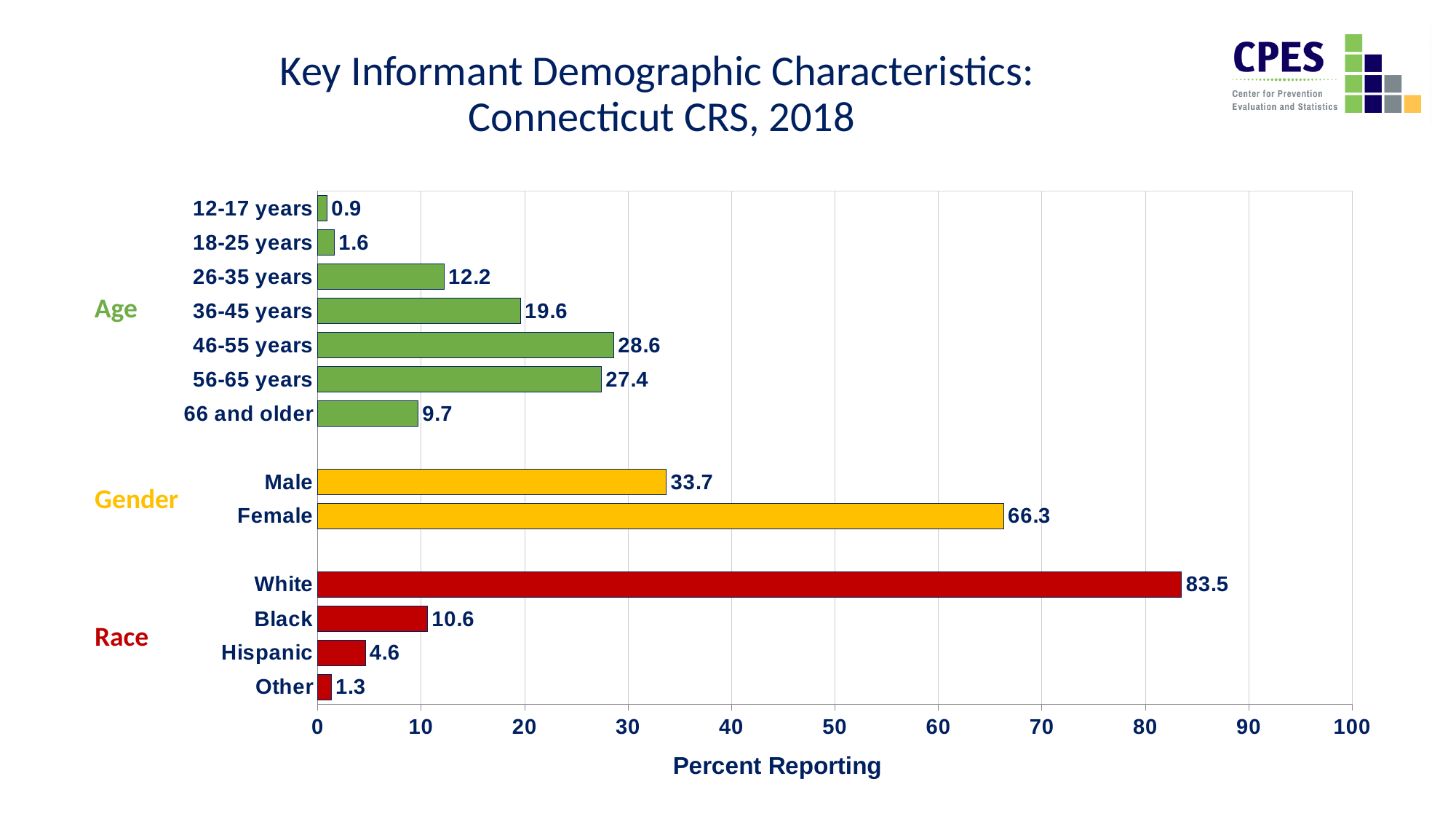
What is the percent reporting for the 46-55 years age group? 28.6 Which has a higher percent reporting, Black or 66 and older? Black What is the label of the x axis? Percent Reporting Which age group has the lowest percent reporting? 12-17 years Is the value for White greater or less than 80? greater Which age group has the highest percent reporting? 46-55 years What is the percent reporting for Hispanic? 4.6 What is the percent reporting for Female? 66.3 How many age groups are shown in the chart? 7 What colour are the bars for the Race categories? Red What is the difference in percent reporting between Female and Male? 32.6 What kind of chart is shown on the slide? Bar chart